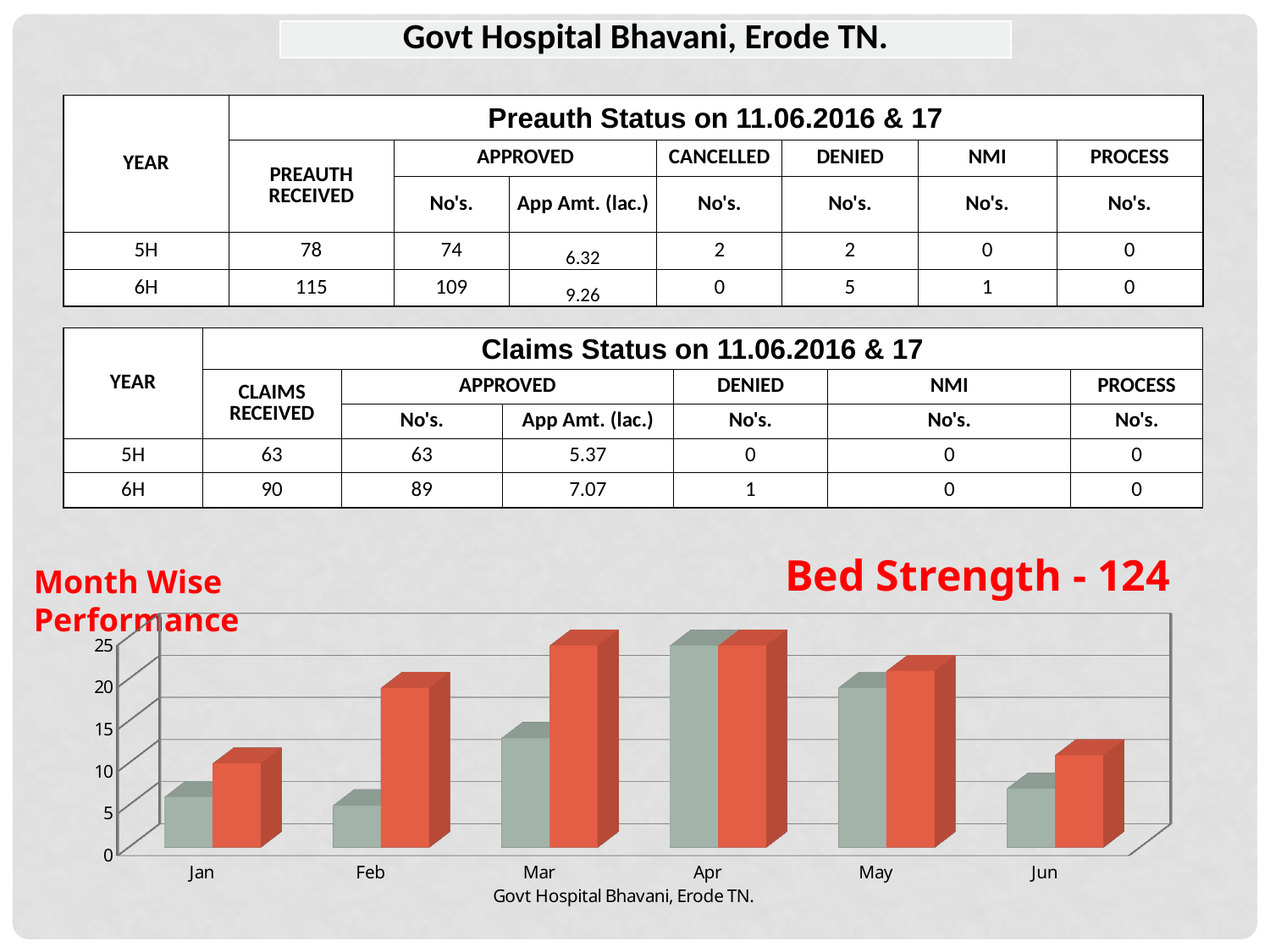
In the Month Wise Performance chart, is the grey bar for Feb greater or less than 10? less What text appears below the month labels on the x axis of the Month Wise Performance chart? Govt Hospital Bhavani, Erode TN. In the Month Wise Performance chart, is the red bar for Feb greater or less than 15? greater In the Month Wise Performance chart, which grey bar is taller, Jan or Apr? Apr What kind of chart is shown under the heading "Month Wise Performance"? bar chart How many months are shown on the x axis of the Month Wise Performance chart? 6 In the Month Wise Performance chart, which is taller for Feb, the grey bar or the red bar? the red bar In the Month Wise Performance chart, which month has the tallest grey bar? Apr In the Month Wise Performance chart, is the red bar for Jun greater or less than 15? less